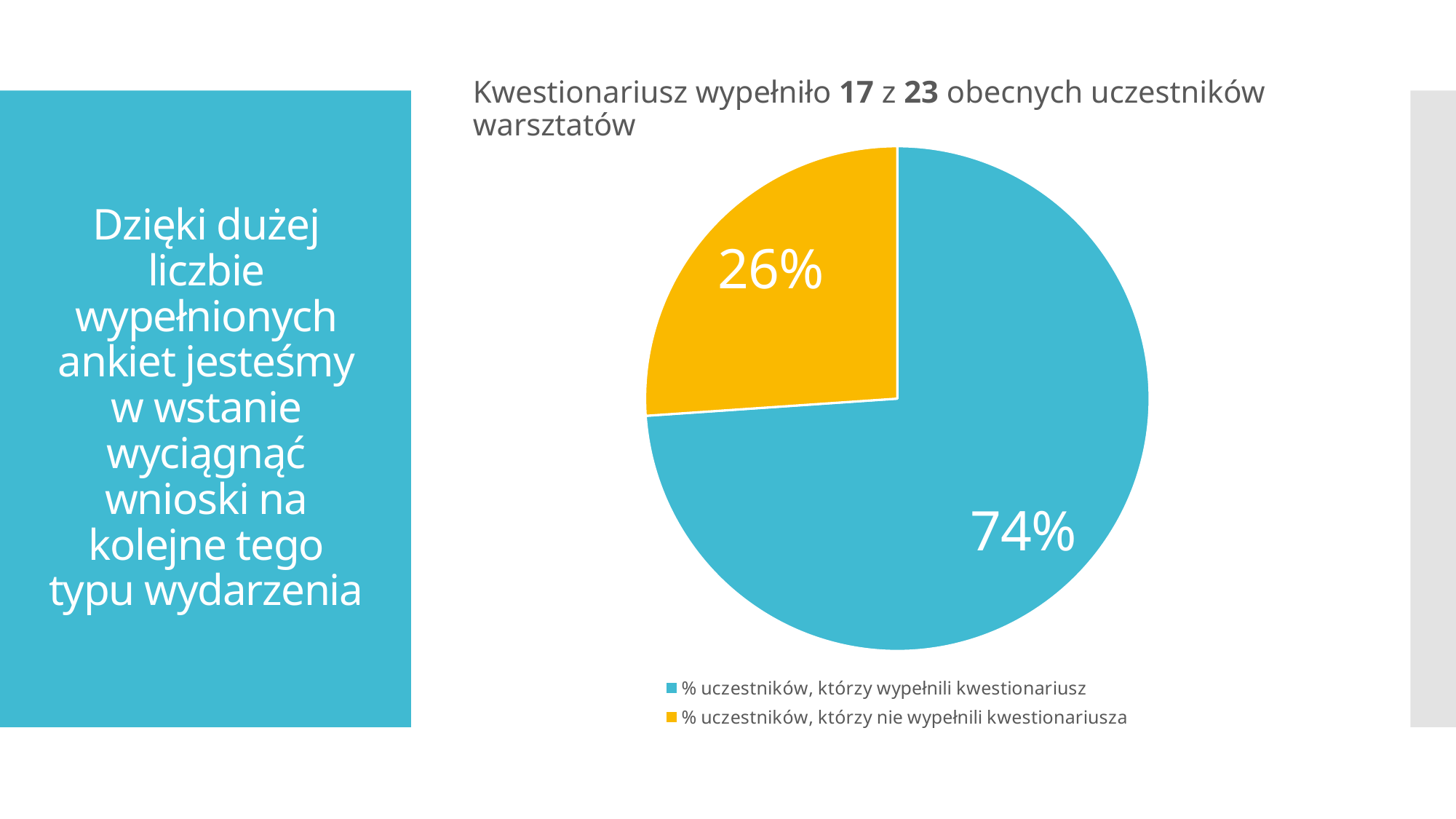
Which slice of the pie is the largest? % uczestników, którzy wypełnili kwestionariusz Which is larger: the slice for participants who filled in the questionnaire or the slice for those who did not? % uczestników, którzy wypełnili kwestionariusz How many slices does the pie chart have? 2 What is the difference in percentage points between the slice for participants who filled in the questionnaire and the slice for those who did not? 48 According to the text above the chart, how many of the 23 present workshop participants filled in the questionnaire? 17 What share of the pie is labelled "% uczestników, którzy wypełnili kwestionariusz"? 74% How many entries does the legend list? 2 What share of the pie is labelled "% uczestników, którzy nie wypełnili kwestionariusza"? 26% What colour is the slice for "% uczestników, którzy nie wypełnili kwestionariusza"? yellow Which slice of the pie is the smallest? % uczestników, którzy nie wypełnili kwestionariusza What kind of chart is shown on the slide? pie chart